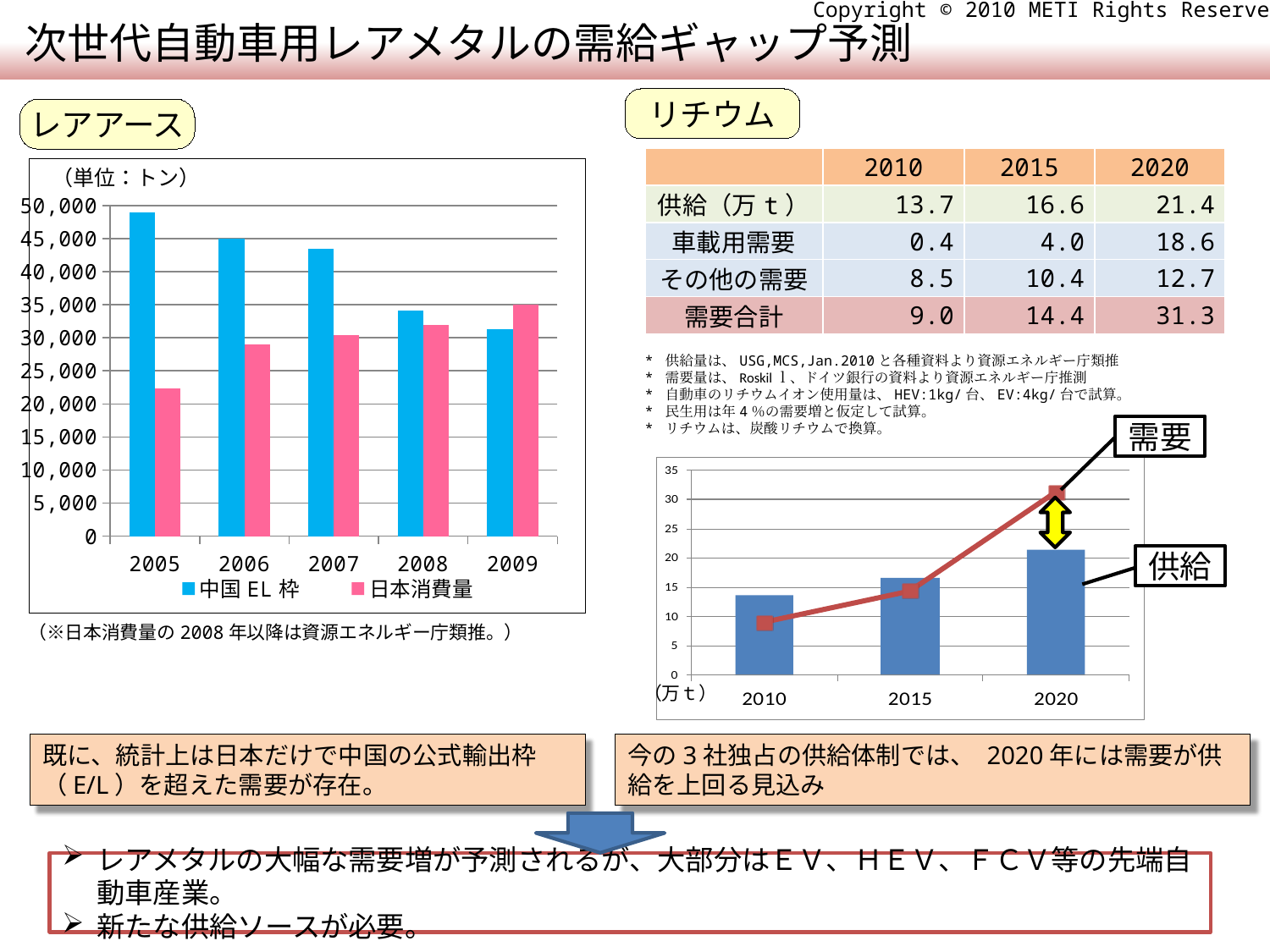
How many years are shown on the x axis of the lithium (リチウム) chart on the right? 3 What kind of chart is the rare earth (レアアース) chart on the left? bar chart How many years are shown on the x axis of the rare earth (レアアース) chart on the left? 5 In the rare earth (レアアース) chart on the left, which year has the lowest value for 日本消費量? 2005 In the rare earth (レアアース) chart on the left, is the value for 日本消費量 in 2005 greater or less than 25,000? less In the rare earth (レアアース) chart on the left, does the value for 中国EL枠 rise or fall from 2005 to 2009? fall In the rare earth (レアアース) chart on the left, which year has the highest value for 中国EL枠? 2005 How many series does the legend of the rare earth (レアアース) chart on the left list? 2 In the lithium (リチウム) chart on the right, does the 需要 line rise or fall from 2010 to 2020? rise In the rare earth (レアアース) chart on the left, is the value for 中国EL枠 in 2005 greater or less than 45,000? greater In the rare earth (レアアース) chart on the left, which series is larger in 2009, 中国EL枠 or 日本消費量? 日本消費量 In the lithium (リチウム) chart on the right, is the 需要 value for 2020 greater or less than 30? greater